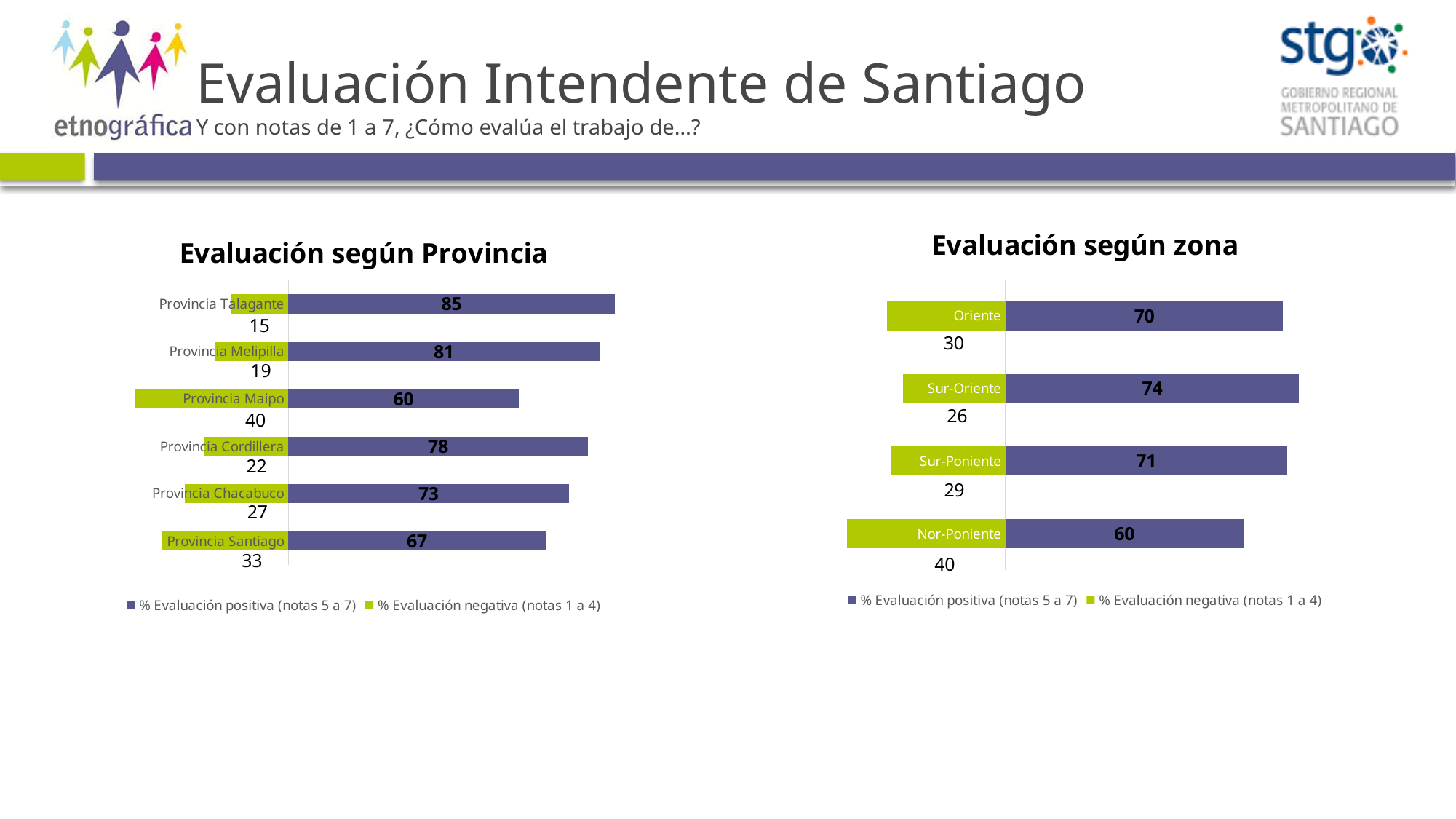
In the 'Evaluación según zona' chart, which zone has the highest % Evaluación positiva? Sur-Oriente In the 'Evaluación según zona' chart, what is the % Evaluación positiva for Sur-Oriente? 74 What type of chart is 'Evaluación según zona'? Bar chart In the 'Evaluación según zona' chart, which is larger, the % Evaluación positiva for Oriente or for Nor-Poniente? Oriente In the 'Evaluación según Provincia' chart, what is the % Evaluación negativa for Provincia Maipo? 40 In the 'Evaluación según Provincia' chart, what is the % Evaluación positiva for Provincia Talagante? 85 In the 'Evaluación según Provincia' chart, what is the difference between the % Evaluación positiva for Provincia Melipilla and Provincia Santiago? 14 In the 'Evaluación según zona' chart, what is the % Evaluación negativa for Nor-Poniente? 40 In the 'Evaluación según zona' chart, how many series does the legend list? 2 In the 'Evaluación según Provincia' chart, how many provinces are shown? 6 In the 'Evaluación según Provincia' chart, which province has the highest % Evaluación positiva? Provincia Talagante In the 'Evaluación según Provincia' chart, which province has the lowest % Evaluación positiva? Provincia Maipo